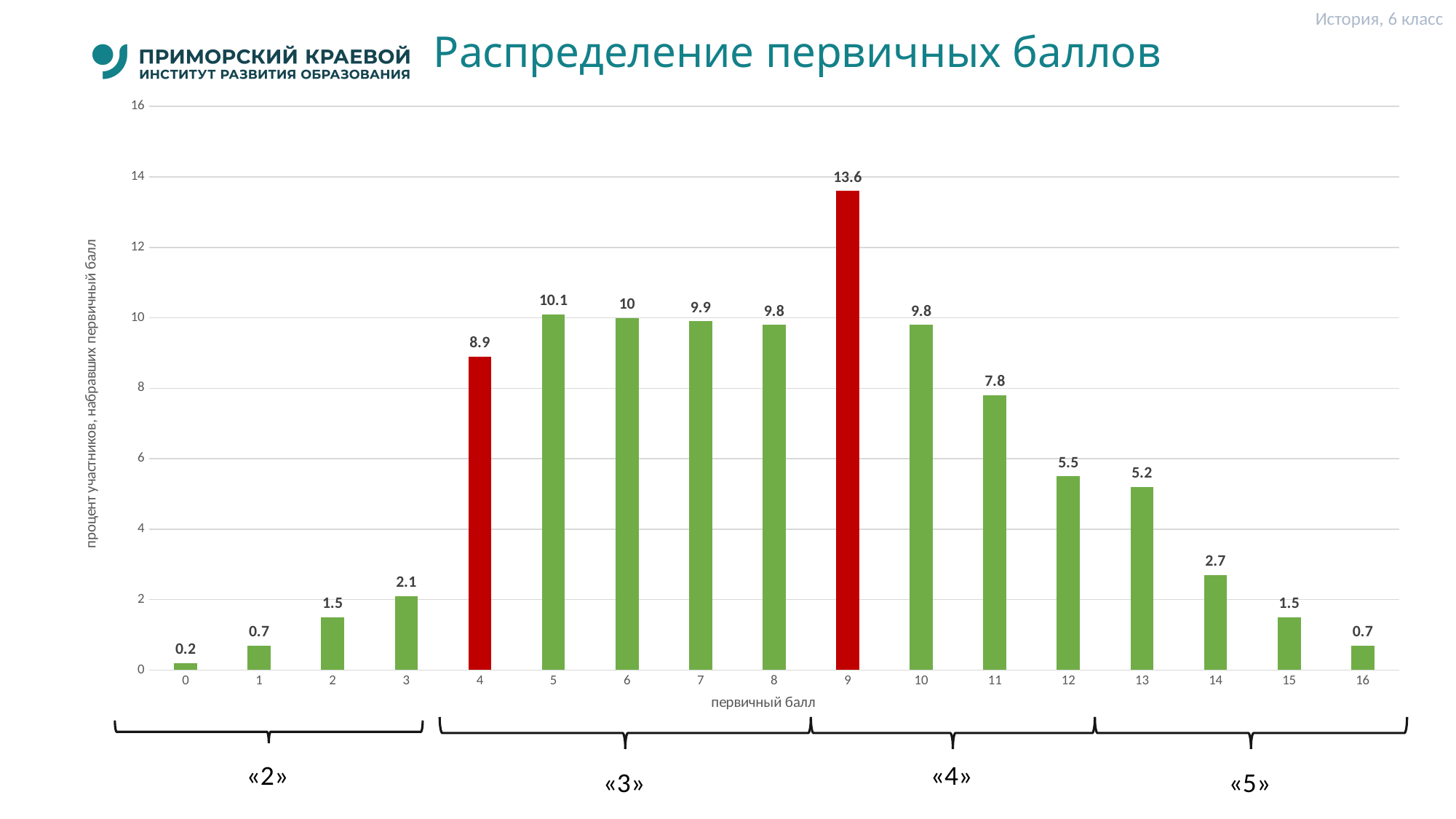
Do the values rise or fall along the x axis from primary score 10 to 16? fall What is the value for primary score 4? 8.9 Which primary scores are shown with red bars? 4 and 9 What is the difference between the values for primary scores 9 and 10? 3.8 What is the title of the chart? Распределение первичных баллов How many primary score categories are shown on the x axis? 17 Which is larger, the value for primary score 11 or primary score 12? 11 What is the value for primary score 13? 5.2 Which primary score has the highest percentage of participants? 9 Which primary score has the lowest percentage of participants? 0 What is the value for primary score 9? 13.6 What kind of chart is shown on the slide? bar chart